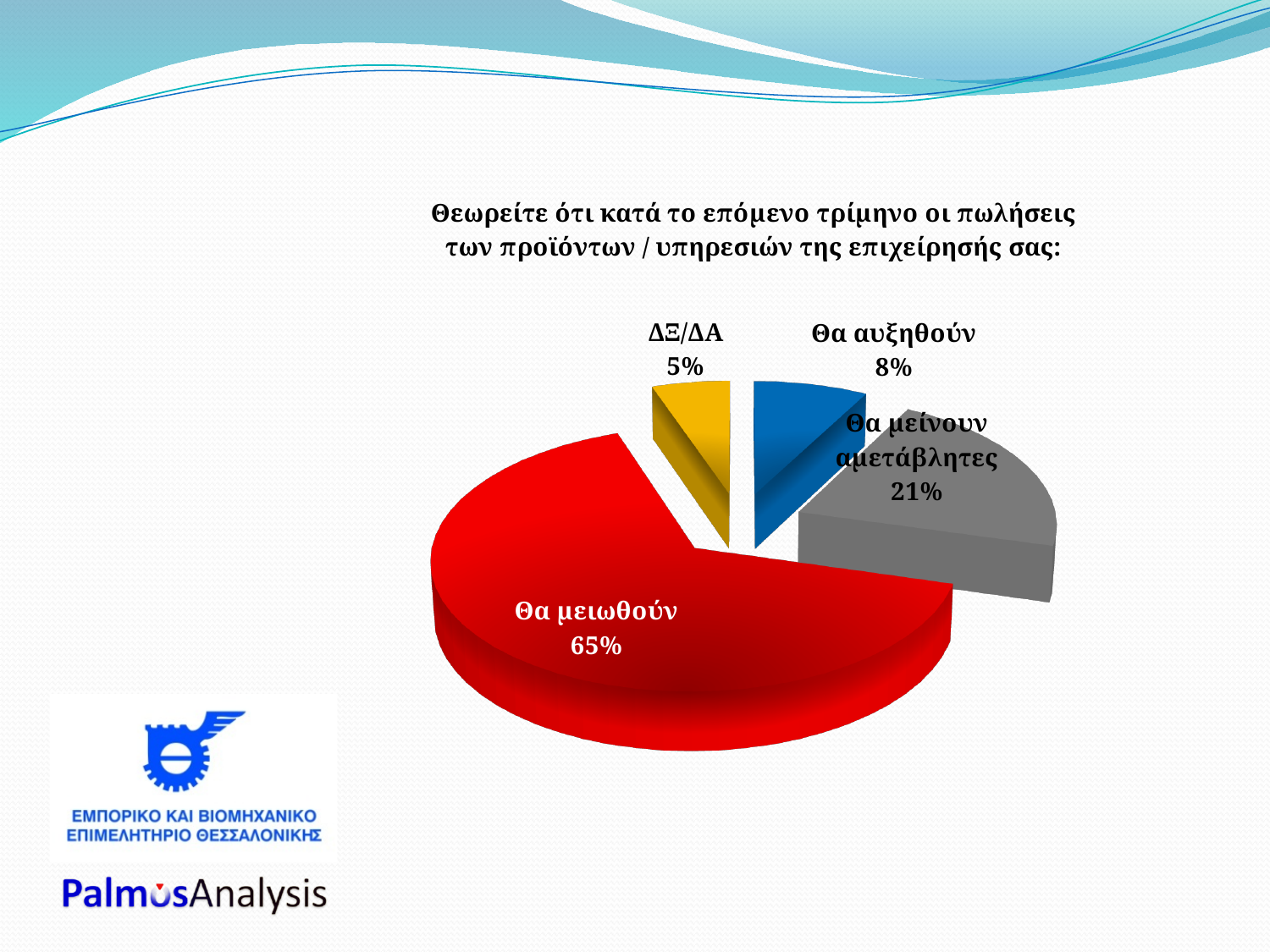
What percentage of respondents answered "Θα μείνουν αμετάβλητες"? 21% Which is larger, the share for "Θα αυξηθούν" or the share for "Θα μείνουν αμετάβλητες"? Θα μείνουν αμετάβλητες Which response has the smallest share of the pie? ΔΞ/ΔΑ What is the difference in percentage points between "Θα μειωθούν" and "Θα μείνουν αμετάβλητες"? 44 How many slices does the pie chart have? 4 What percentage of respondents answered "ΔΞ/ΔΑ"? 5% What is the combined share of "Θα αυξηθούν" and "ΔΞ/ΔΑ"? 13% What percentage of respondents answered "Θα μειωθούν"? 65% What percentage of respondents answered "Θα αυξηθούν"? 8% What kind of chart is shown on the slide? Pie chart Which response has the largest share of the pie? Θα μειωθούν What colour is the slice for "Θα μειωθούν"? Red